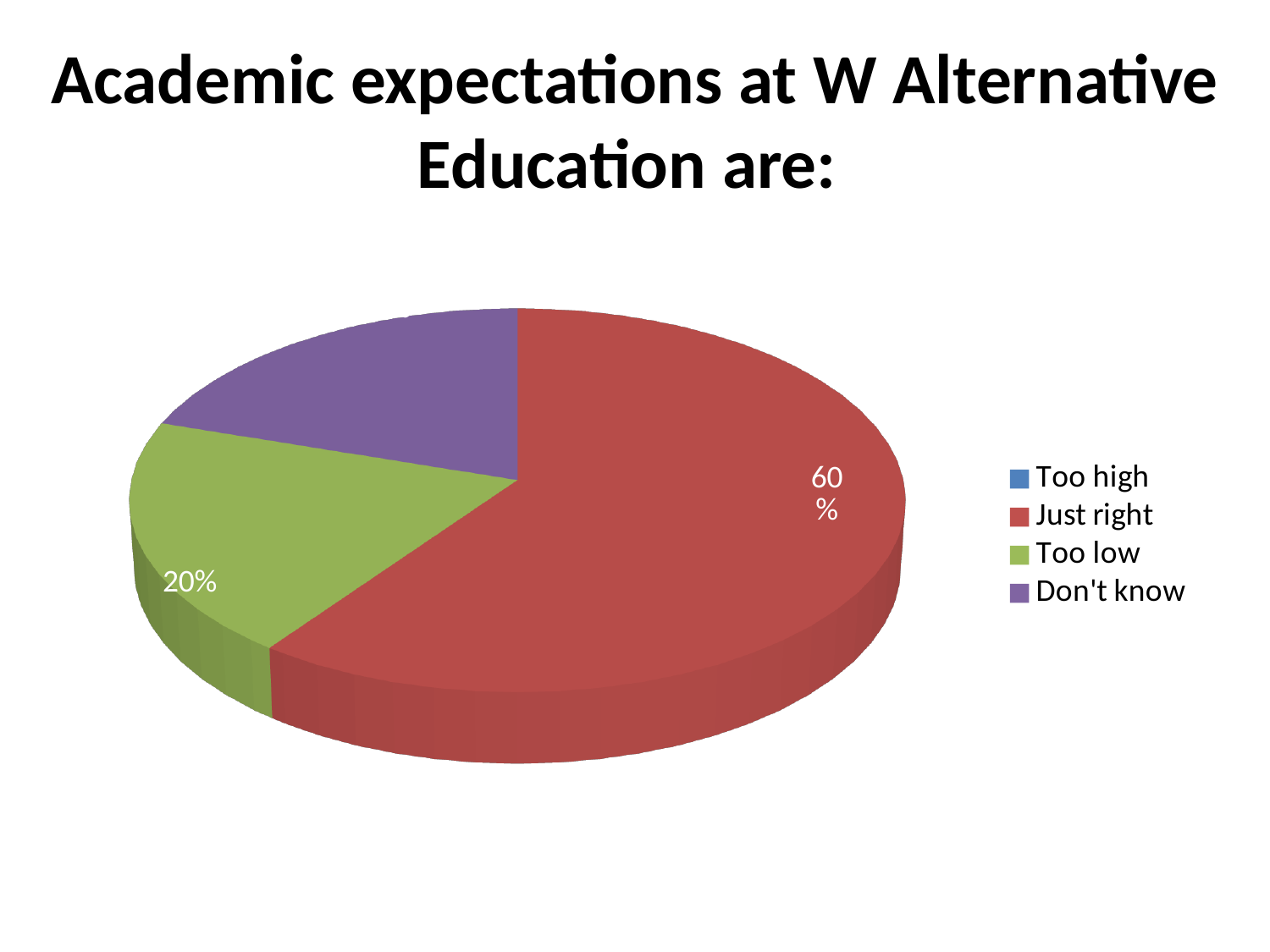
Which is larger, the slice for 'Just right' or the slice for 'Too low'? Just right Which is larger, the slice for 'Just right' or the slice for 'Don't know'? Just right What colour is the 'Just right' slice? Red By how many percentage points does 'Just right' exceed 'Too low'? 40 What percentage of the pie is labelled for 'Just right'? 60% What kind of chart is shown on the slide? Pie chart Which category has the largest slice of the pie? Just right What percentage of the pie is labelled for 'Too low'? 20% What is the title of the slide? Academic expectations at W Alternative Education are: How many entries does the legend list? 4